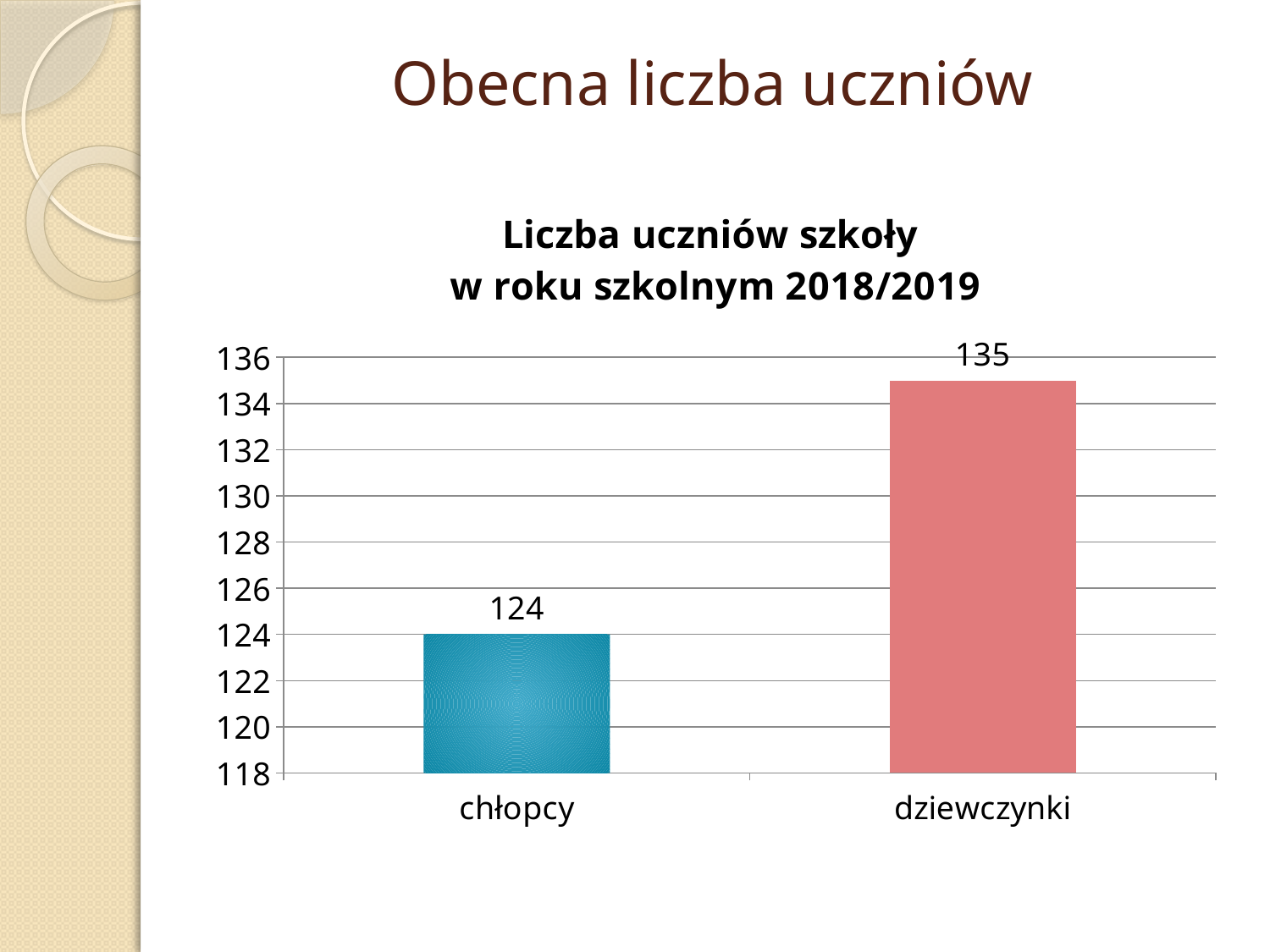
What is the value for dziewczynki? 135 Which category has the highest value? dziewczynki How many categories are shown on the x axis? 2 What is the value for chłopcy? 124 What colour is the bar for dziewczynki? red Which is larger, the value for chłopcy or the value for dziewczynki? dziewczynki Is the value for dziewczynki greater or less than 130? greater What is the difference between the values for dziewczynki and chłopcy? 11 What is the title of the chart? Liczba uczniów szkoły w roku szkolnym 2018/2019 Which category has the lowest value? chłopcy What kind of chart is shown on the slide? bar chart Is the value for chłopcy greater or less than 130? less